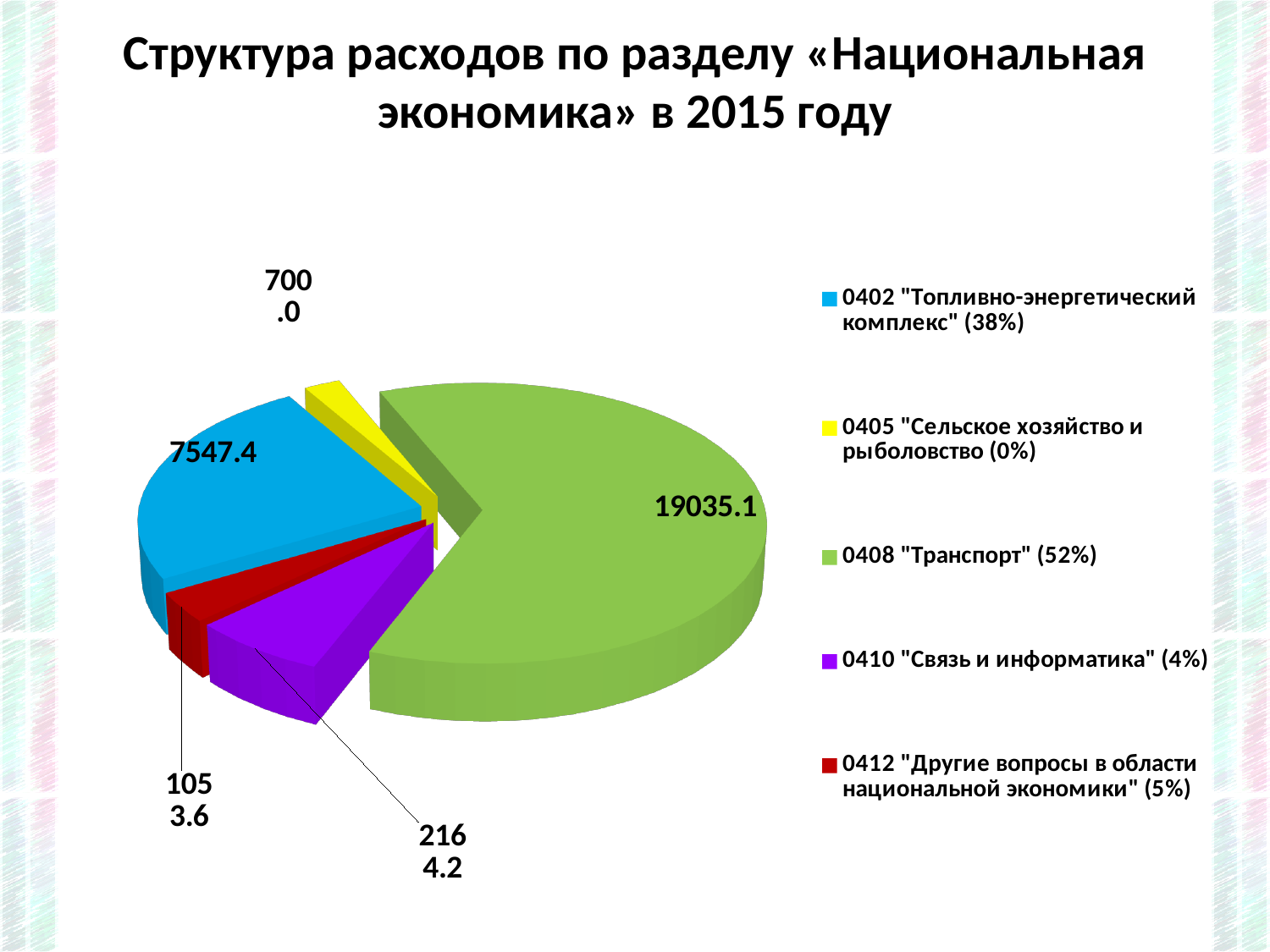
Which category has the largest slice of the pie? 0408 "Транспорт" What is the value for 0405 "Сельское хозяйство и рыболовство"? 700.0 What share of the pie does 0408 "Транспорт" represent, according to the legend? 52% What is the value for 0408 "Транспорт"? 19035.1 What is the difference between the values for 0408 "Транспорт" and 0402 "Топливно-энергетический комплекс"? 11487.7 What is the value for 0410 "Связь и информатика"? 2164.2 Which category has the smallest slice of the pie? 0405 "Сельское хозяйство и рыболовство" How many categories does the pie chart have? 5 What is the value for 0402 "Топливно-энергетический комплекс"? 7547.4 What type of chart is shown on the slide? pie chart Which is larger: the value for 0410 "Связь и информатика" or the value for 0412 "Другие вопросы в области национальной экономики"? 0410 "Связь и информатика" What is the value for 0412 "Другие вопросы в области национальной экономики"? 1053.6